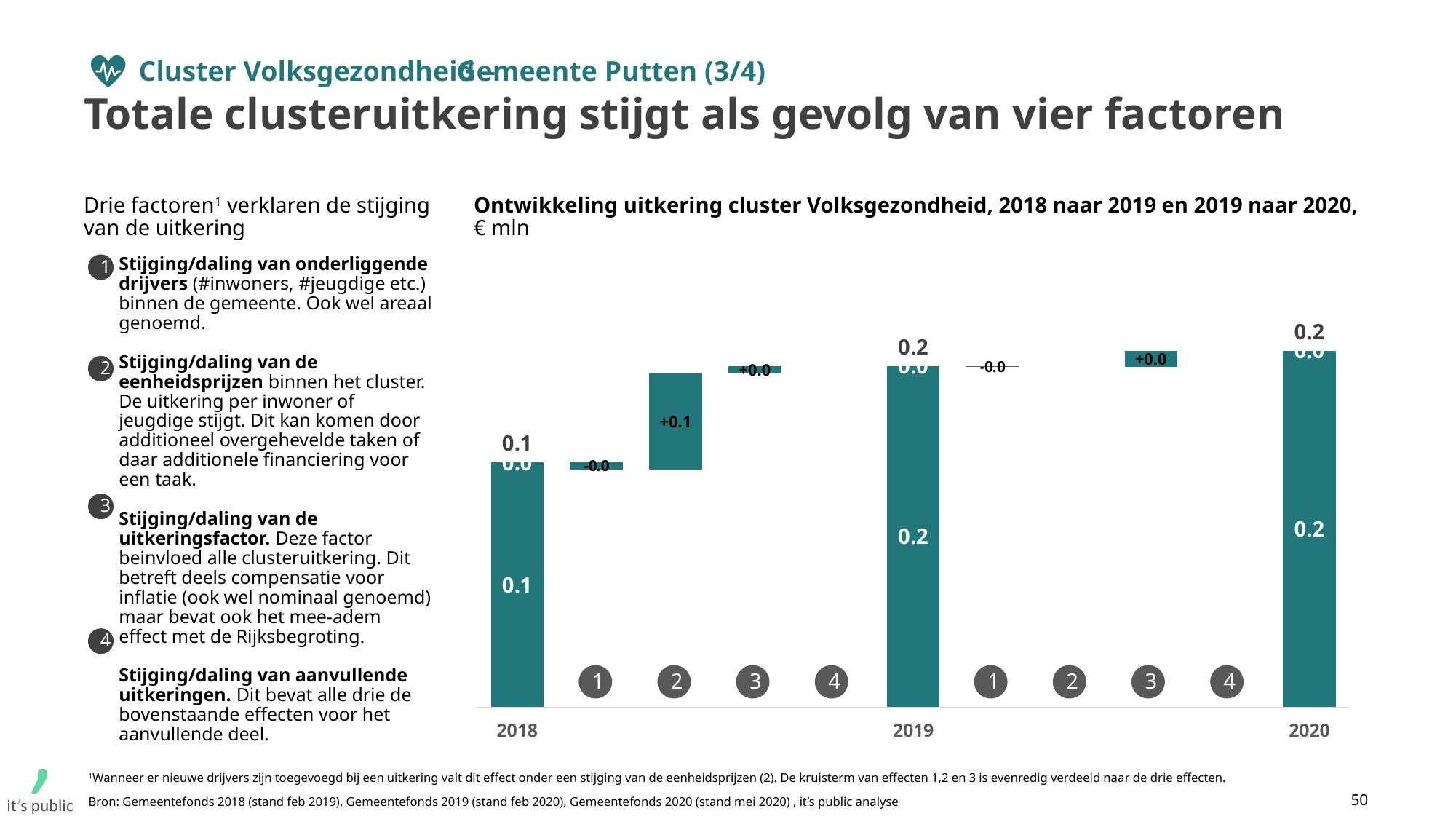
How many year totals are shown in the chart? 3 What is the value of factor 1 in the step from 2018 to 2019? -0.0 Is the total for 2019 larger or smaller than the total for 2018? larger What unit is the chart expressed in, according to its title? € mln What is the total uitkering for 2019 shown above the bar? 0.2 What is the total uitkering for 2018 shown above the bar? 0.1 What is the value of factor 1 in the step from 2019 to 2020? -0.0 What is the difference between the 2019 total and the 2018 total? 0.1 Which year has the lowest total uitkering? 2018 What is the value of factor 2 (eenheidsprijzen) in the step from 2018 to 2019? +0.1 What is the value of factor 3 in the step from 2019 to 2020? +0.0 What is the total uitkering for 2020 shown above the bar? 0.2